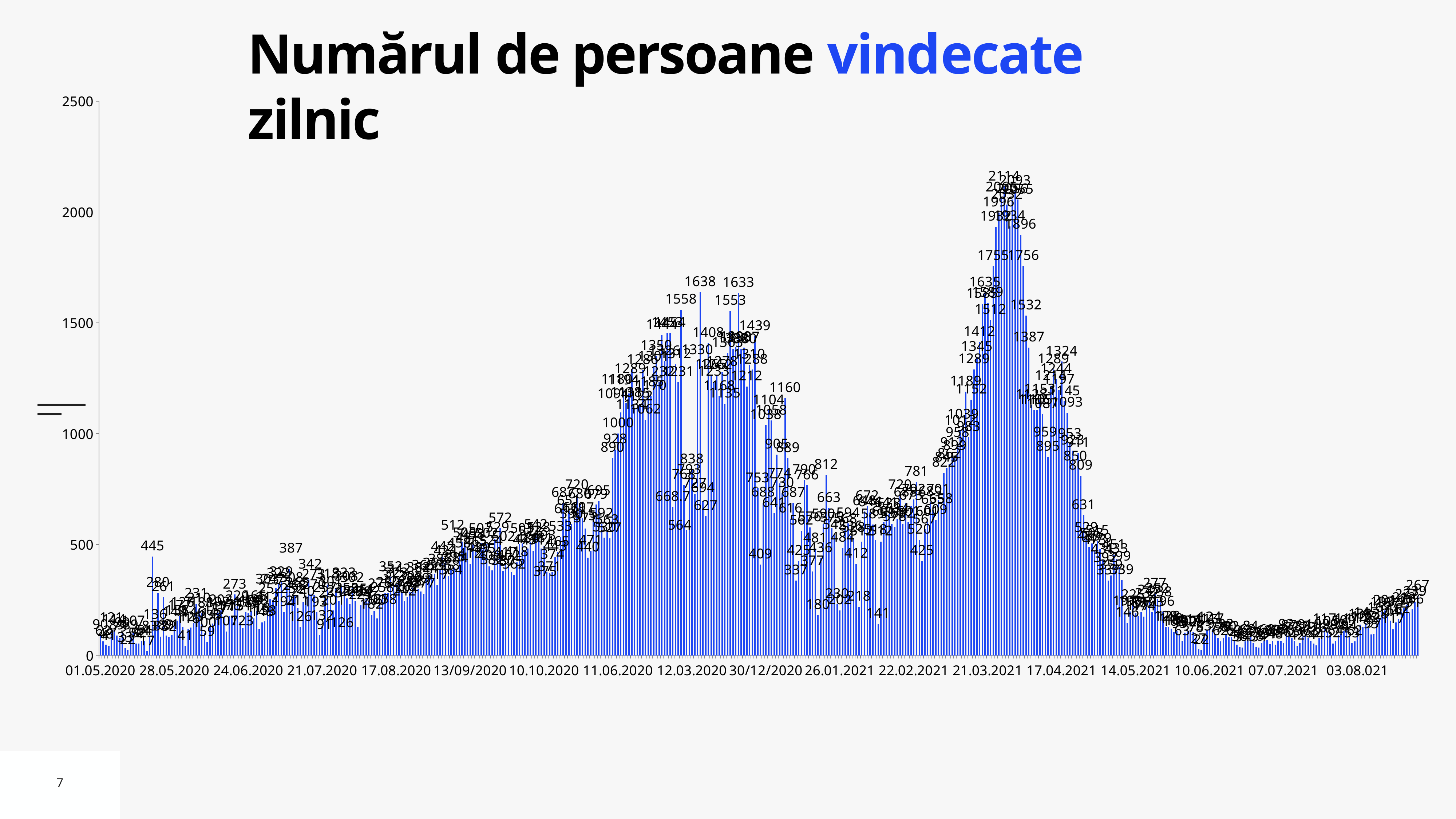
What is the value of the tallest bar in the chart? 2114 What is the difference between the overall peak value (2114) and the peak value around 12.03.2020 (1638)? 476 Do the values rise or fall between 07.07.2021 and 03.08.2021? rise Is the value for 07.07.2021 greater or less than 500? less What is the highest value shown on the y axis? 2500 Do the values rise or fall between 14.05.2021 and 10.06.2021? fall What is the title of the chart? Numărul de persoane vindecate zilnic What kind of chart is shown on the slide? bar chart What is the value of the tallest bar in the peak around 12.03.2020 on the x axis? 1638 Which is larger: the peak around 21.03.2021–17.04.2021 or the peak around 12.03.2020? the peak around 21.03.2021–17.04.2021 What is the value of the isolated spike just before 28.05.2020? 445 Is the value of the tallest bar greater or less than 2000? greater